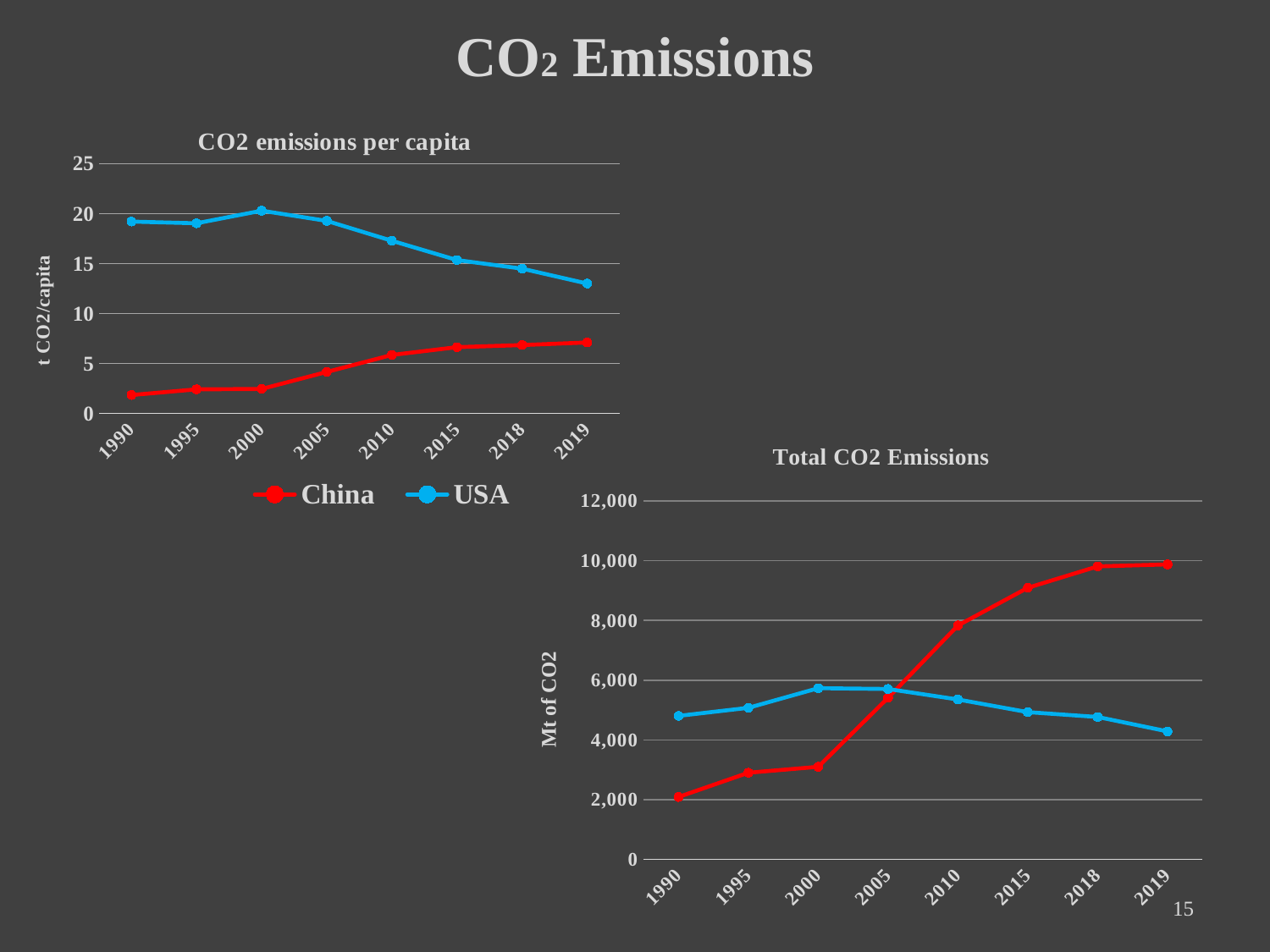
In the "Total CO2 Emissions" chart, is the China value for 2019 greater or less than 8,000? greater In the "Total CO2 Emissions" chart, does the China line rise or fall from 1990 to 2019? rise What kind of chart is the "CO2 emissions per capita" chart? line chart In the "CO2 emissions per capita" chart, is the China value for 2019 greater or less than 5? greater In the "CO2 emissions per capita" chart, does the USA line rise or fall from 2000 to 2019? fall In the "Total CO2 Emissions" chart, which country has the larger value in 2019, China or USA? China In the "CO2 emissions per capita" chart, is the USA value for 2019 greater or less than 15? less How many years are shown on the x axis of the "Total CO2 Emissions" chart? 8 In the "Total CO2 Emissions" chart, which country has the larger value in 1990, China or USA? USA How many series does the legend of the "CO2 emissions per capita" chart list? 2 What is the y-axis label of the "Total CO2 Emissions" chart? Mt of CO2